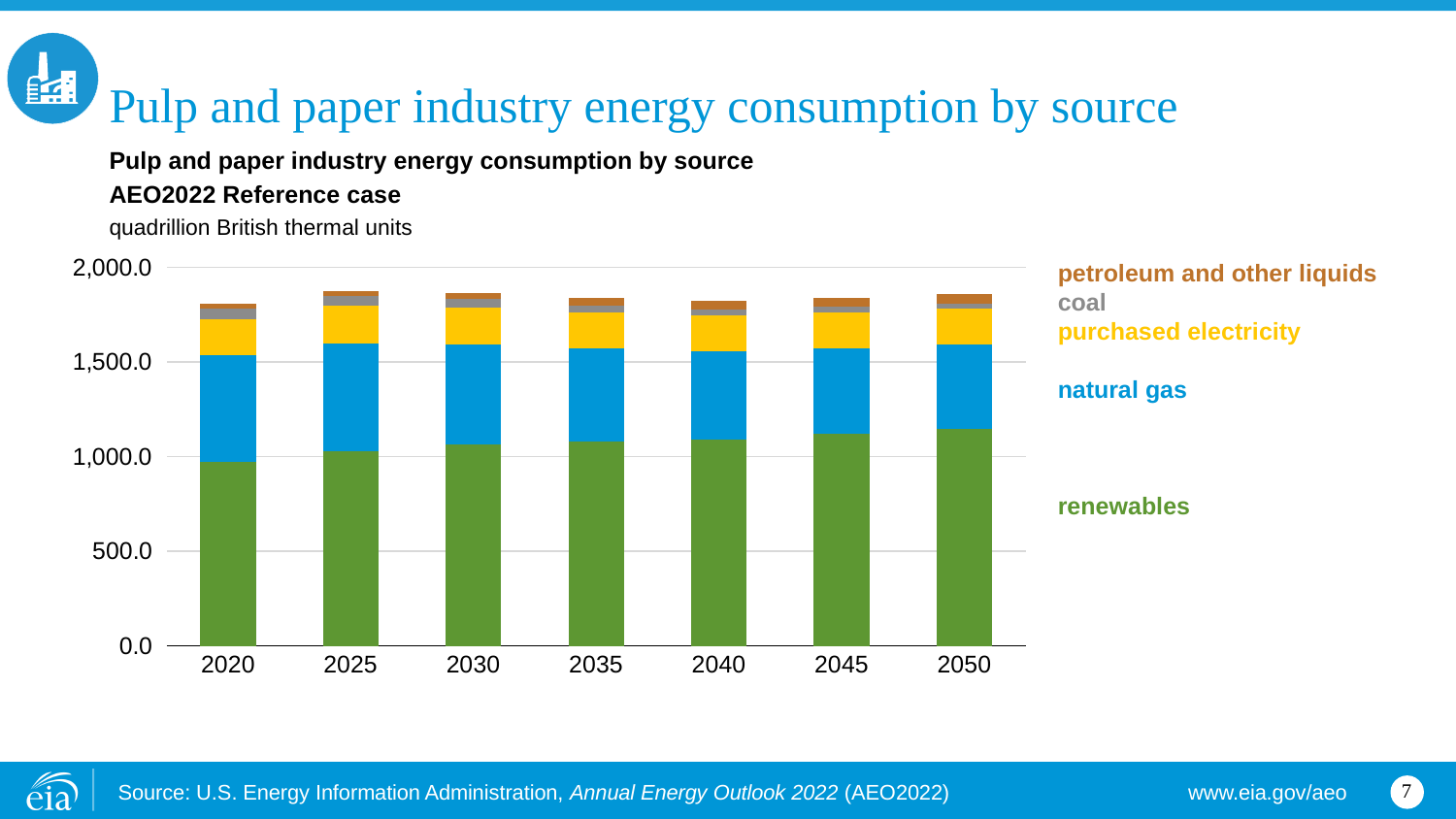
What unit of measurement is the chart plotted in? quadrillion British thermal units What kind of chart is shown on the slide? stacked bar chart How many years are shown along the x axis of the chart? 7 Is the renewables value for 2050 greater or less than 1,000.0? greater Which year has the larger renewables value, 2020 or 2050? 2050 Is the total height of the stacked bar for 2025 greater or less than 1,500.0? greater In which year is the renewables segment the largest? 2050 Does the renewables segment rise or fall from 2020 to 2050? rises Is the renewables value for 2020 greater or less than 1,000.0? less How many energy sources does the chart's legend list? 5 In which year is the renewables segment the smallest? 2020